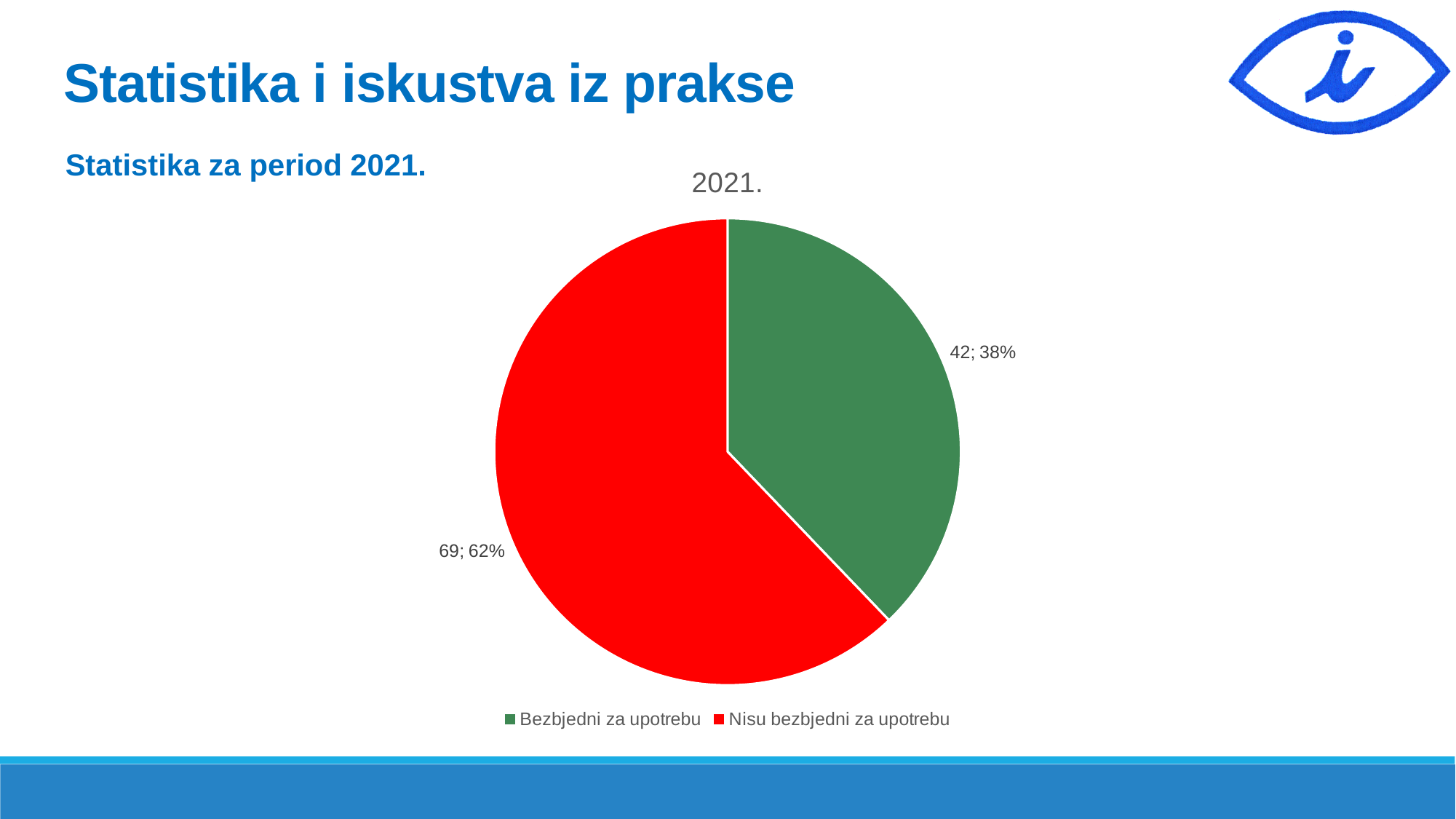
What share of the pie does "Bezbjedni za upotrebu" represent? 38% Which category has the smallest slice? Bezbjedni za upotrebu How many slices does the pie chart have? 2 What is the difference between the values for "Nisu bezbjedni za upotrebu" and "Bezbjedni za upotrebu"? 27 Which category has the largest slice? Nisu bezbjedni za upotrebu Which colour represents "Nisu bezbjedni za upotrebu" in the chart? red What is the value for "Nisu bezbjedni za upotrebu"? 69 What share of the pie does "Nisu bezbjedni za upotrebu" represent? 62% How many entries does the legend list? 2 What kind of chart is shown on the slide? pie chart What is the value for "Bezbjedni za upotrebu"? 42 What is the title of the chart? 2021.